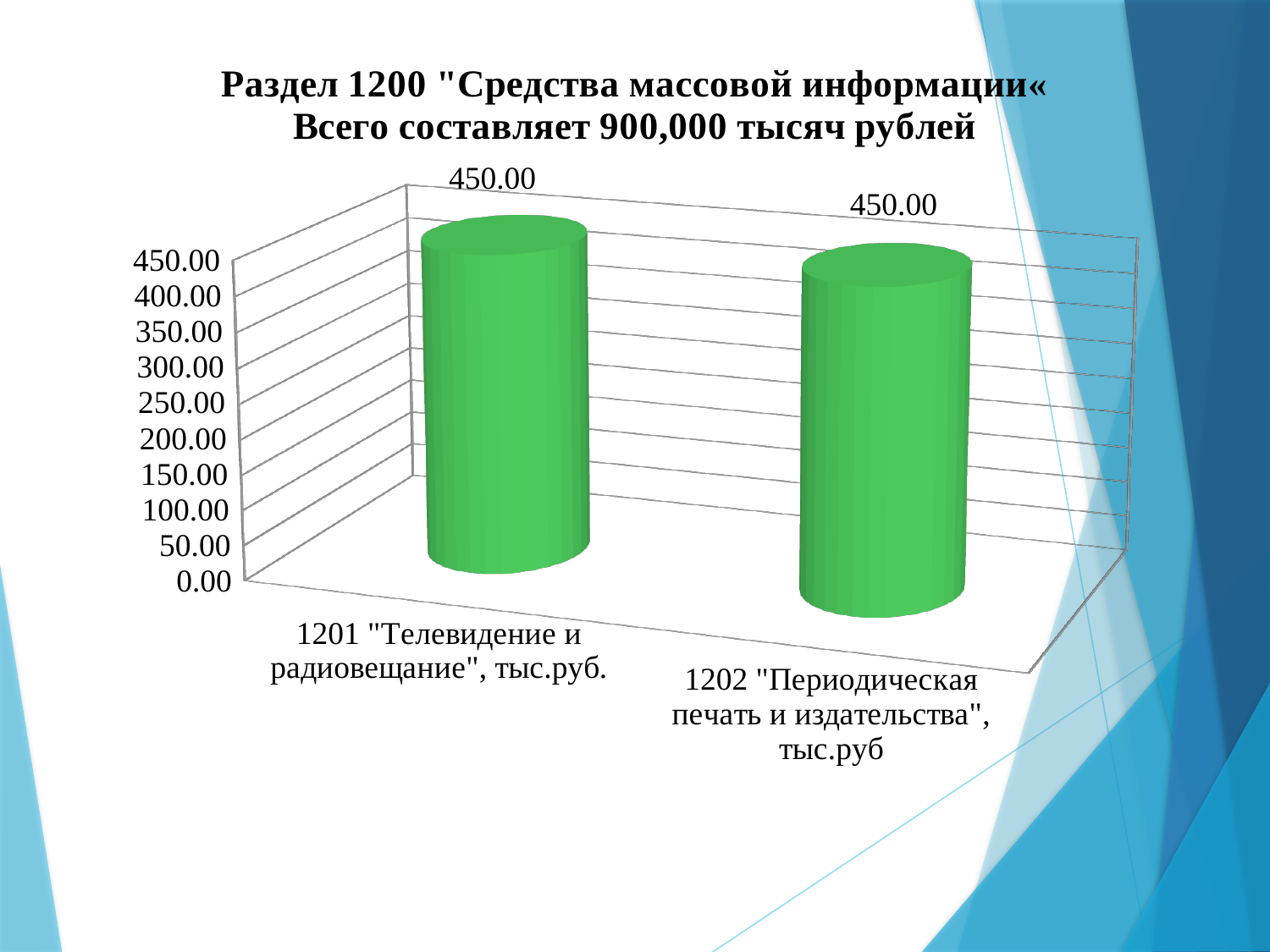
Is the value for 1202 "Периодическая печать и издательства" greater or less than 300.00? greater What is the difference between the values for 1201 "Телевидение и радиовещание" and 1202 "Периодическая печать и издательства"? 0.00 What is the highest value shown on the vertical axis? 450.00 What is the total of the two plotted values? 900.00 What is the value for 1201 "Телевидение и радиовещание"? 450.00 What kind of chart is shown on the slide? Bar chart How many categories are plotted on the chart? 2 What colour are the bars on the chart? Green Is the value for 1201 "Телевидение и радиовещание" greater or less than 400.00? greater What is the value for 1202 "Периодическая печать и издательства"? 450.00